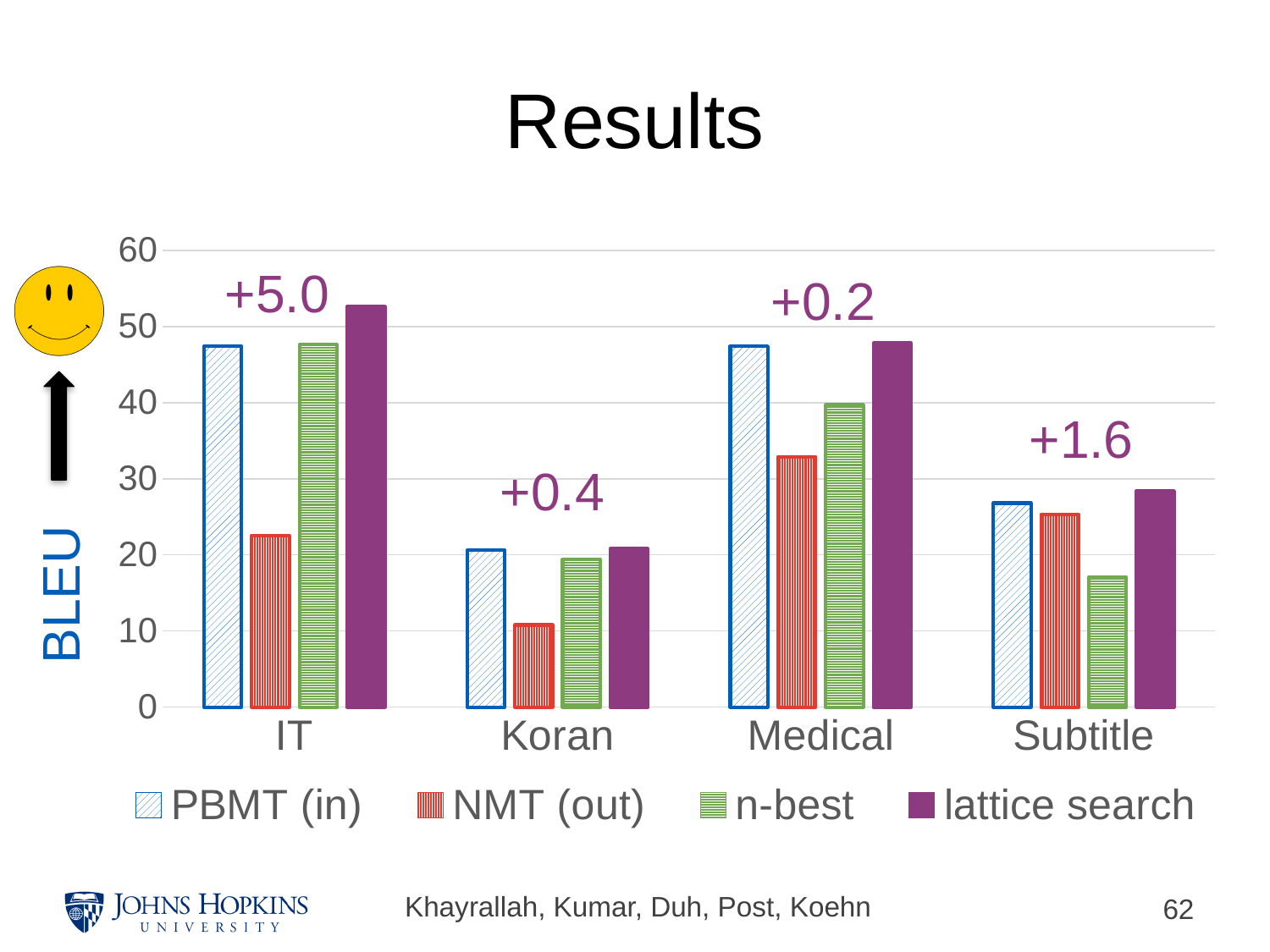
What is the label on the y axis of the chart? BLEU How many series does the legend list? 4 How many categories are shown on the x axis of the chart? 4 For IT, which is larger: NMT (out) or n-best? n-best Is the lattice search value for IT greater or less than 50? greater For Subtitle, which is larger: NMT (out) or n-best? NMT (out) Which category has the highest lattice search bar? IT What kind of chart is shown on the slide? bar chart Which category has the lowest NMT (out) bar? Koran Is the n-best value for Medical greater or less than 30? greater Is the NMT (out) value for Koran greater or less than 20? less What improvement is annotated above the IT group of bars? +5.0